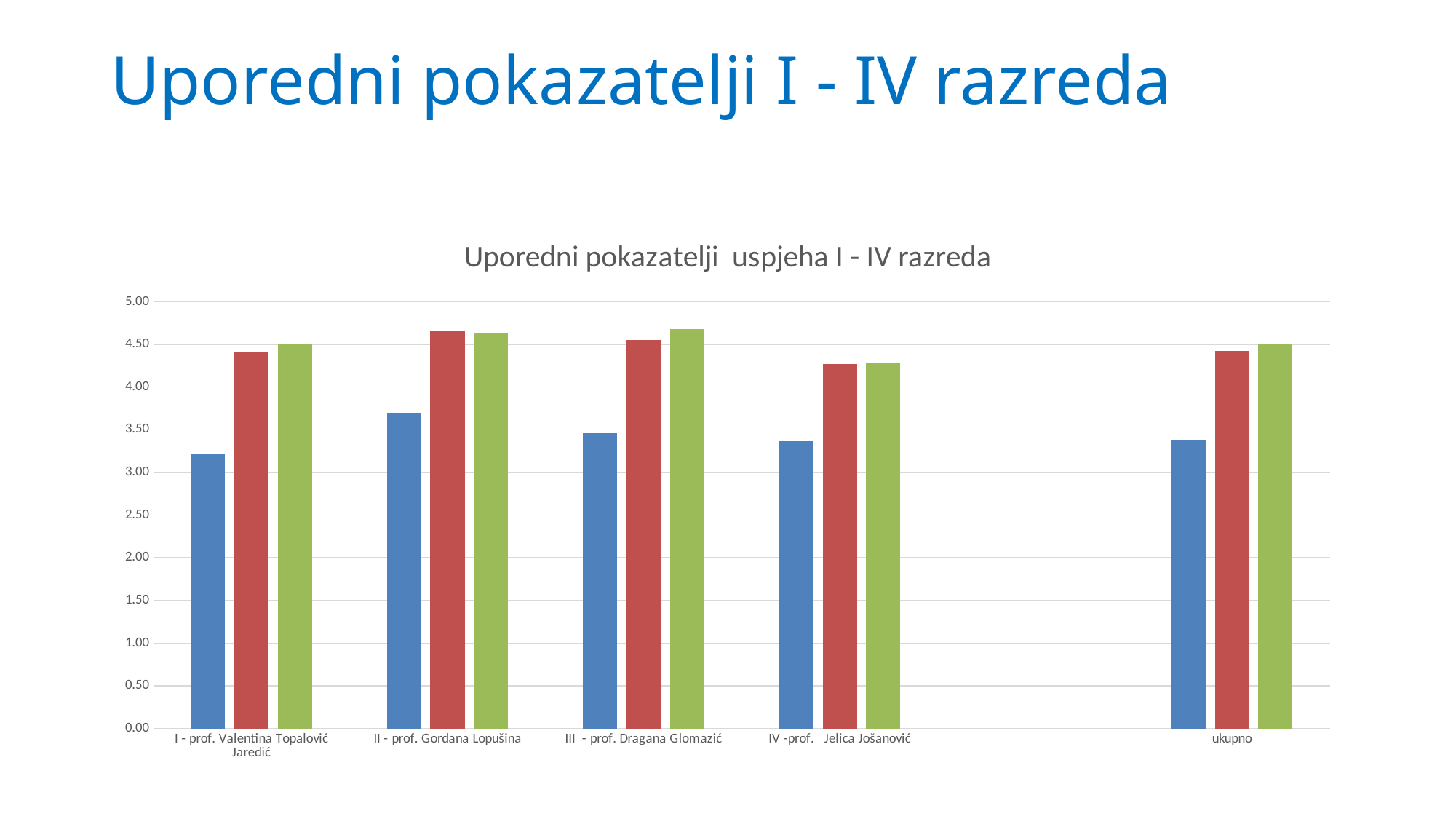
Is the value of the blue bar for 'ukupno' greater or less than 3.50? less Is the value of the red bar for 'II - prof. Gordana Lopušina' greater or less than 4.50? greater Which category has the lowest blue bar? I - prof. Valentina Topalović Jaredić For 'III - prof. Dragana Glomazić', which is larger: the blue bar or the red bar? the red bar How many categories are shown along the x axis of the chart? 5 Is the value of the blue bar for 'II - prof. Gordana Lopušina' greater or less than 3.50? greater What kind of chart is shown on the slide? bar chart How many bars are plotted for each category in the chart? 3 Which category has the highest blue bar? II - prof. Gordana Lopušina What is the title of the chart? Uporedni pokazatelji uspjeha I - IV razreda